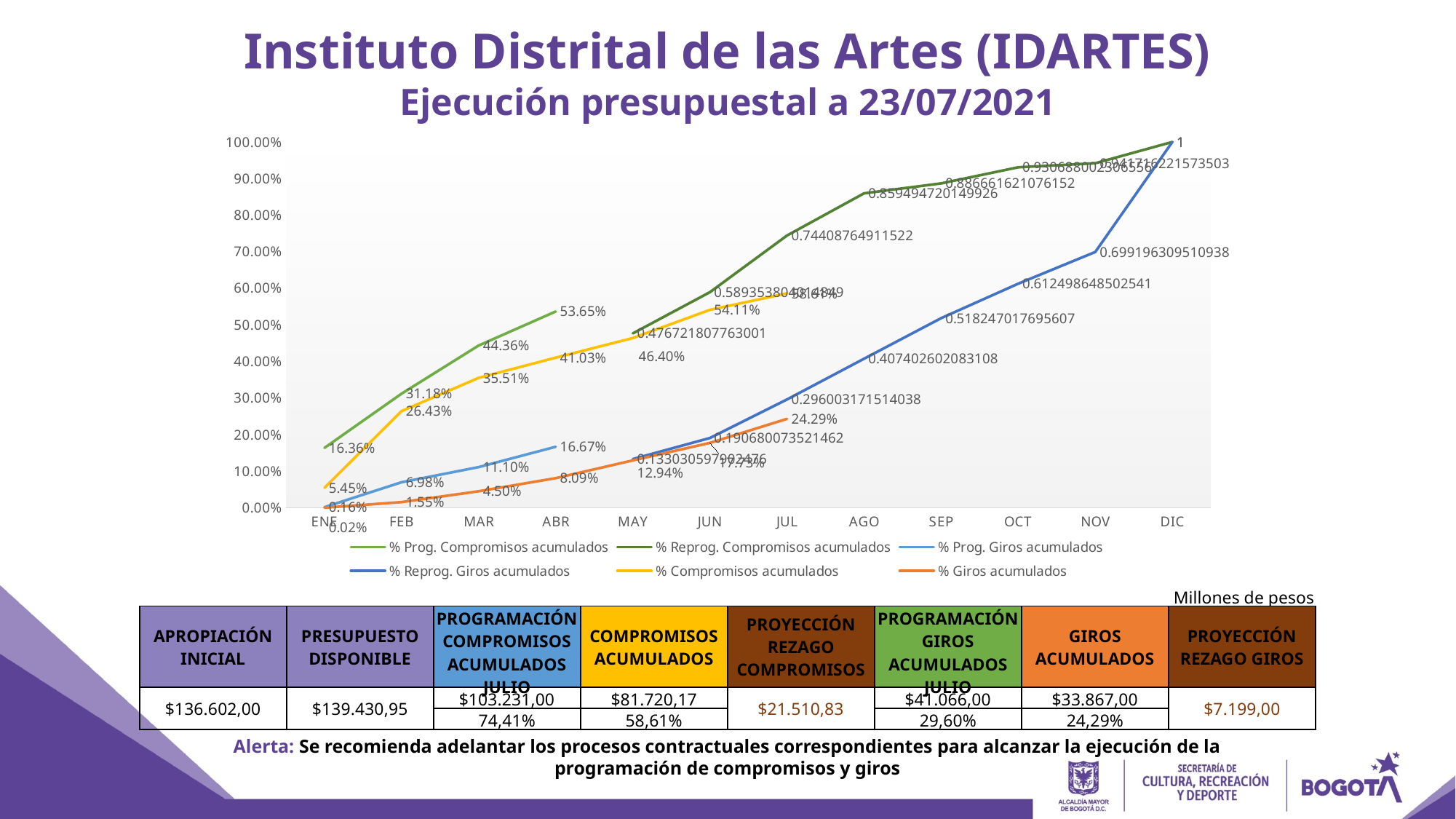
Does % Giros acumulados rise or fall from ENE to JUL? rise How many months are shown along the x axis of the chart? 12 How many series does the chart legend list? 6 What kind of chart is shown on the slide? line chart What is the value of % Reprog. Giros acumulados in OCT? 0.612498648502541 What is the value of % Giros acumulados in JUL? 24.29% What is the value of % Compromisos acumulados in JUL? 58.61% What is the value of % Prog. Compromisos acumulados in ABR? 53.65% What is the value of % Prog. Giros acumulados in MAR? 11.10% Is the value of % Reprog. Giros acumulados in SEP greater or less than 50.00%? greater What is the difference between % Compromisos acumulados and % Giros acumulados in JUL? 34.32% In MAY, which is larger: % Compromisos acumulados or % Giros acumulados? % Compromisos acumulados